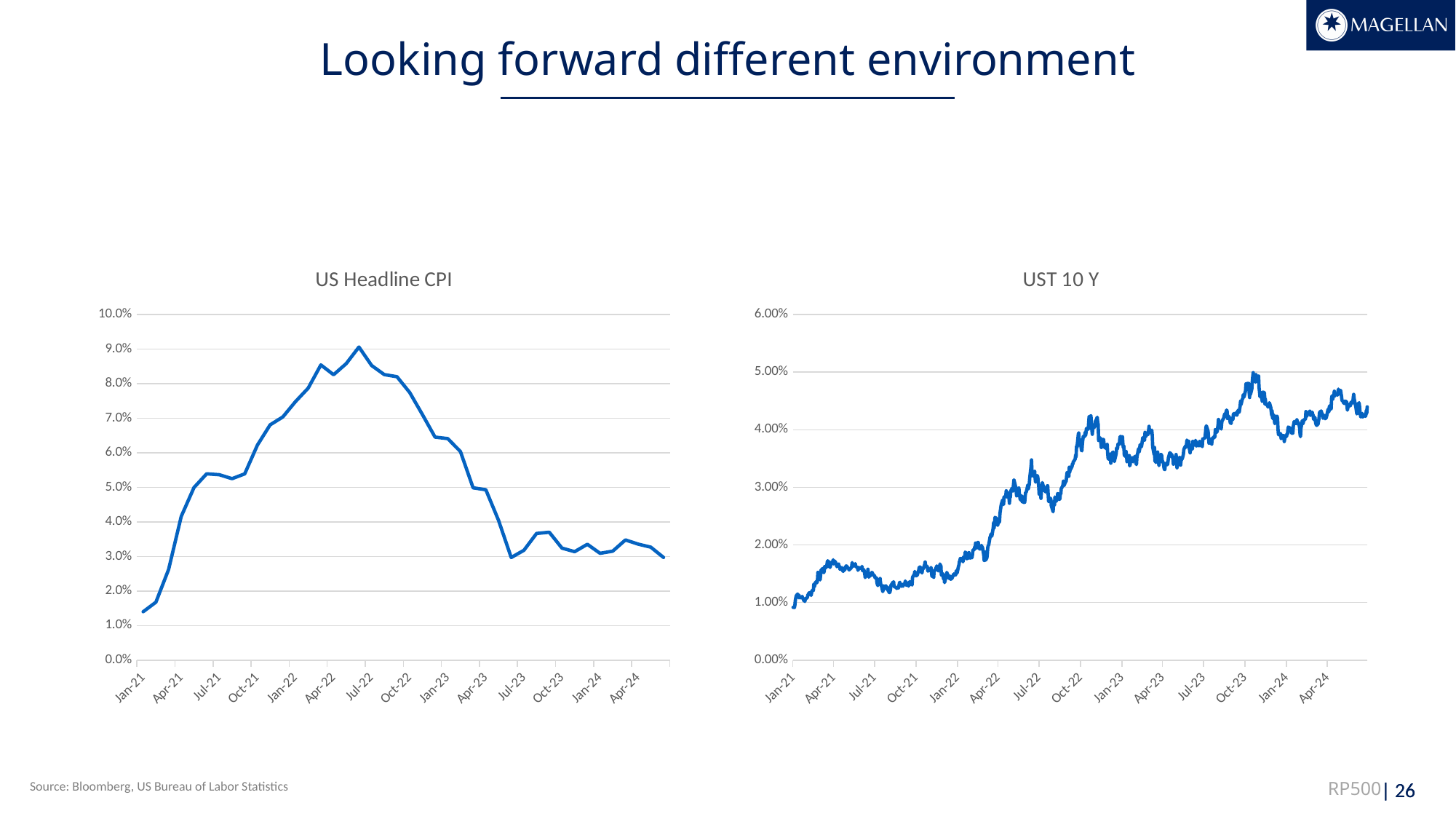
What kind of chart is the US Headline CPI chart? line chart In the UST 10 Y chart, is the value at Jan-21 greater or less than 2.00%? less What is the title of the chart on the right side of the slide? UST 10 Y In the US Headline CPI chart, does the line rise or fall between Jul-22 and Jul-23? fall What kind of chart is the UST 10 Y chart? line chart In the US Headline CPI chart, around which x-axis label does the line reach its highest point? Jul-22 In the UST 10 Y chart, does the line generally rise or fall from Jan-21 to Apr-24? rise In the UST 10 Y chart, is the value at Oct-23 greater or less than 4.00%? greater In the US Headline CPI chart, is the value at Apr-24 greater or less than 4.0%? less In the UST 10 Y chart, around which x-axis label does the line reach its highest point? Oct-23